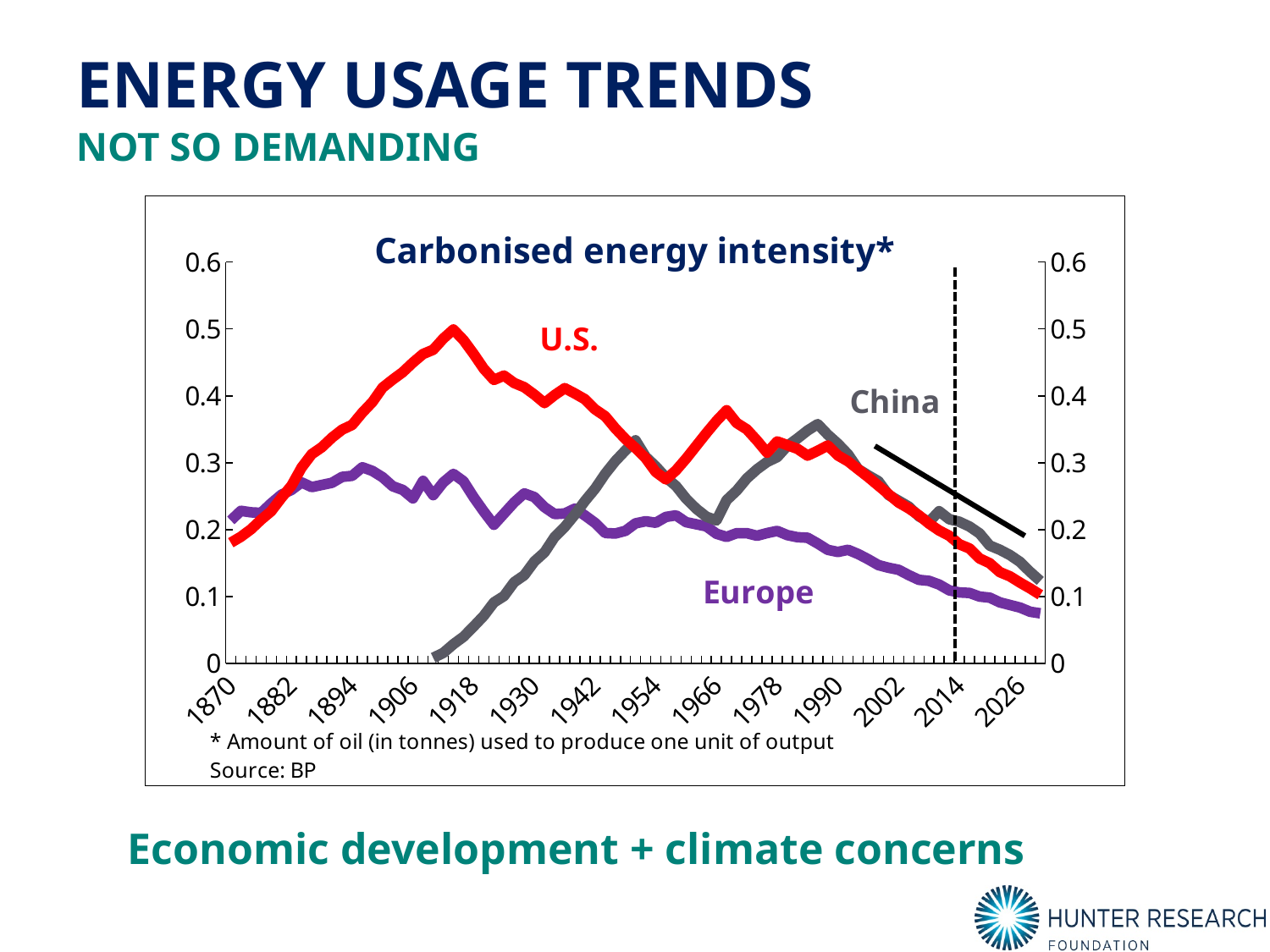
What kind of chart is shown on the slide? line chart Is the peak value of the U.S. line (around 1918) greater or less than 0.4? greater Does the Europe line rise or fall between 1990 and 2026? fall Is the value for China around 1990 greater or less than 0.3? greater Is the value for Europe around 1990 greater or less than 0.3? less How many series (countries/regions) are plotted on the chart? 3 Around 1990, which is higher: the China line or the Europe line? China What is the source given for the chart data? BP Which series reaches the highest value on the chart? U.S. Around 1918, which is higher: the U.S. line or the Europe line? U.S. What is the title of the chart? Carbonised energy intensity*